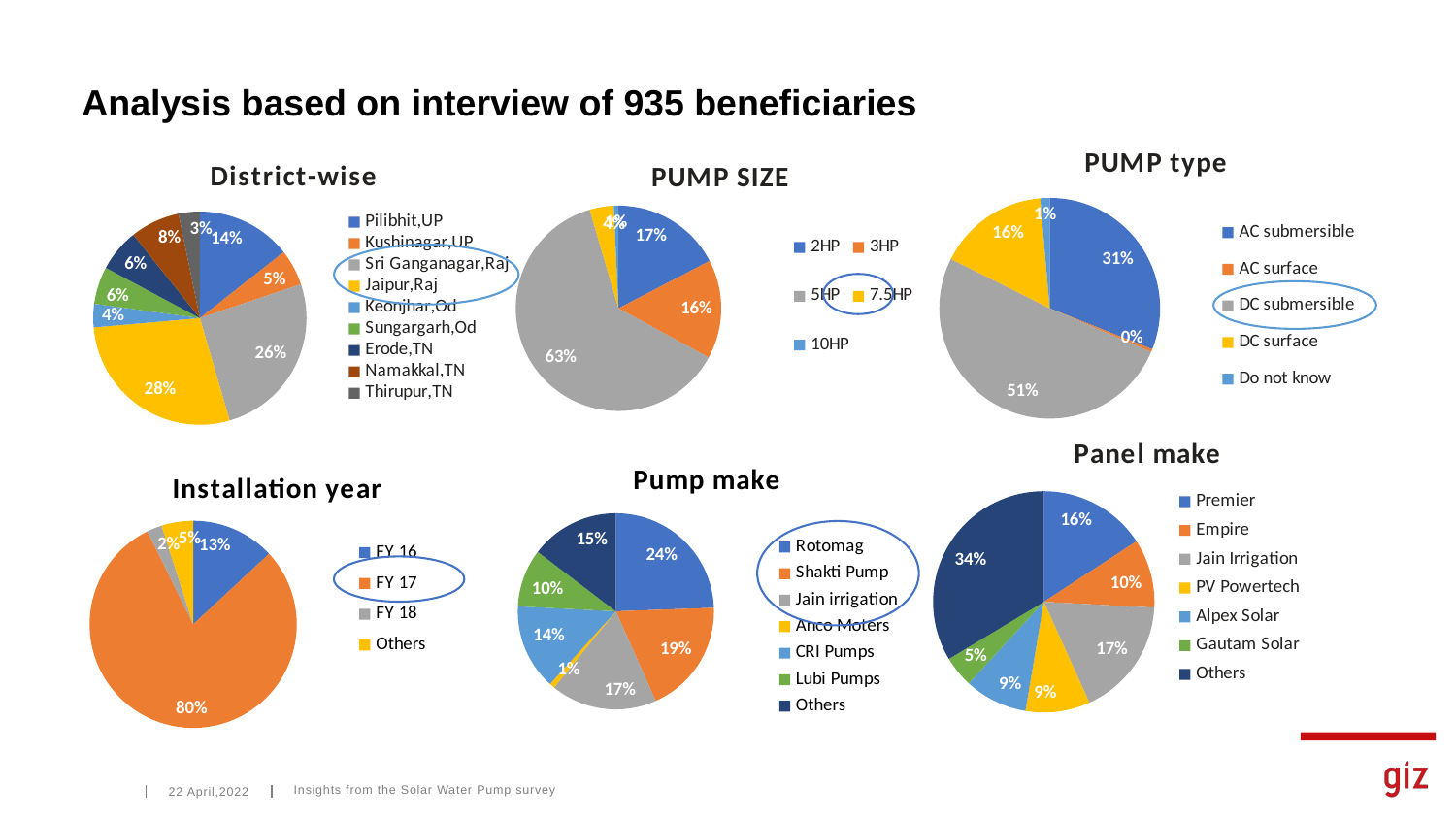
In the Pump make chart, which is larger, Rotomag or Shakti Pump? Rotomag In the Panel make chart, what is the share for Jain Irrigation? 17% In the PUMP type chart, which pump type has the largest share? DC submersible In the PUMP type chart, what share is DC surface? 16% In the PUMP SIZE chart, what is the difference between the 2HP and 3HP shares? 1% In the District-wise chart, what percentage of beneficiaries are from Jaipur,Raj? 28% What type of chart is used for the Panel make data? Pie chart In the District-wise chart, which district has the smallest share? Thirupur,TN In the PUMP SIZE chart, what share do 5HP pumps have? 63% In the Pump make chart, what share does CRI Pumps have? 14% How many categories does the legend of the Installation year chart list? 4 In the Installation year chart, what share of installations were in FY 17? 80%